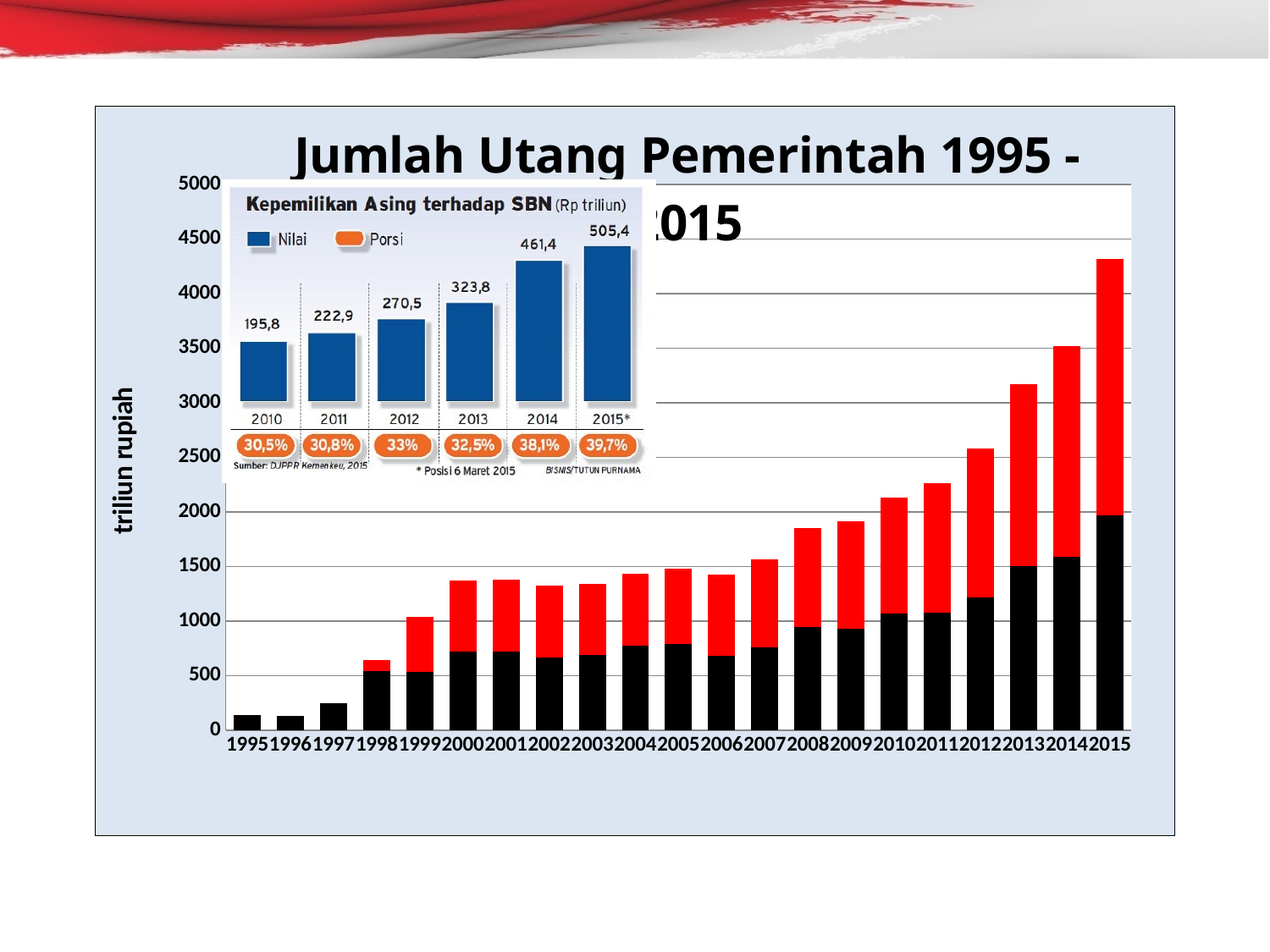
In the inset chart 'Kepemilikan Asing terhadap SBN', what is the value for 2014? 461,4 In the main chart 'Jumlah Utang Pemerintah 1995 - 2015', is the total bar for 1995 greater or less than 500? less In the main chart 'Jumlah Utang Pemerintah 1995 - 2015', is the total bar for 2015 greater or less than 4000? greater In the inset chart 'Kepemilikan Asing terhadap SBN', what is the value for 2010? 195,8 In the main chart 'Jumlah Utang Pemerintah 1995 - 2015', how many years are shown on the x axis? 21 In the inset chart 'Kepemilikan Asing terhadap SBN', do the values rise or fall from 2010 to 2015*? rise In the inset chart 'Kepemilikan Asing terhadap SBN', what percentage (Porsi) is shown for 2015*? 39,7% In the inset chart 'Kepemilikan Asing terhadap SBN', what is the difference between the values for 2013 and 2012? 53,3 In the inset chart 'Kepemilikan Asing terhadap SBN', which year has the lowest value? 2010 In the inset chart 'Kepemilikan Asing terhadap SBN', which year has the highest value? 2015* In the inset chart 'Kepemilikan Asing terhadap SBN', how many entries does the legend list? 2 What kind of chart is the main chart 'Jumlah Utang Pemerintah 1995 - 2015'? stacked bar chart